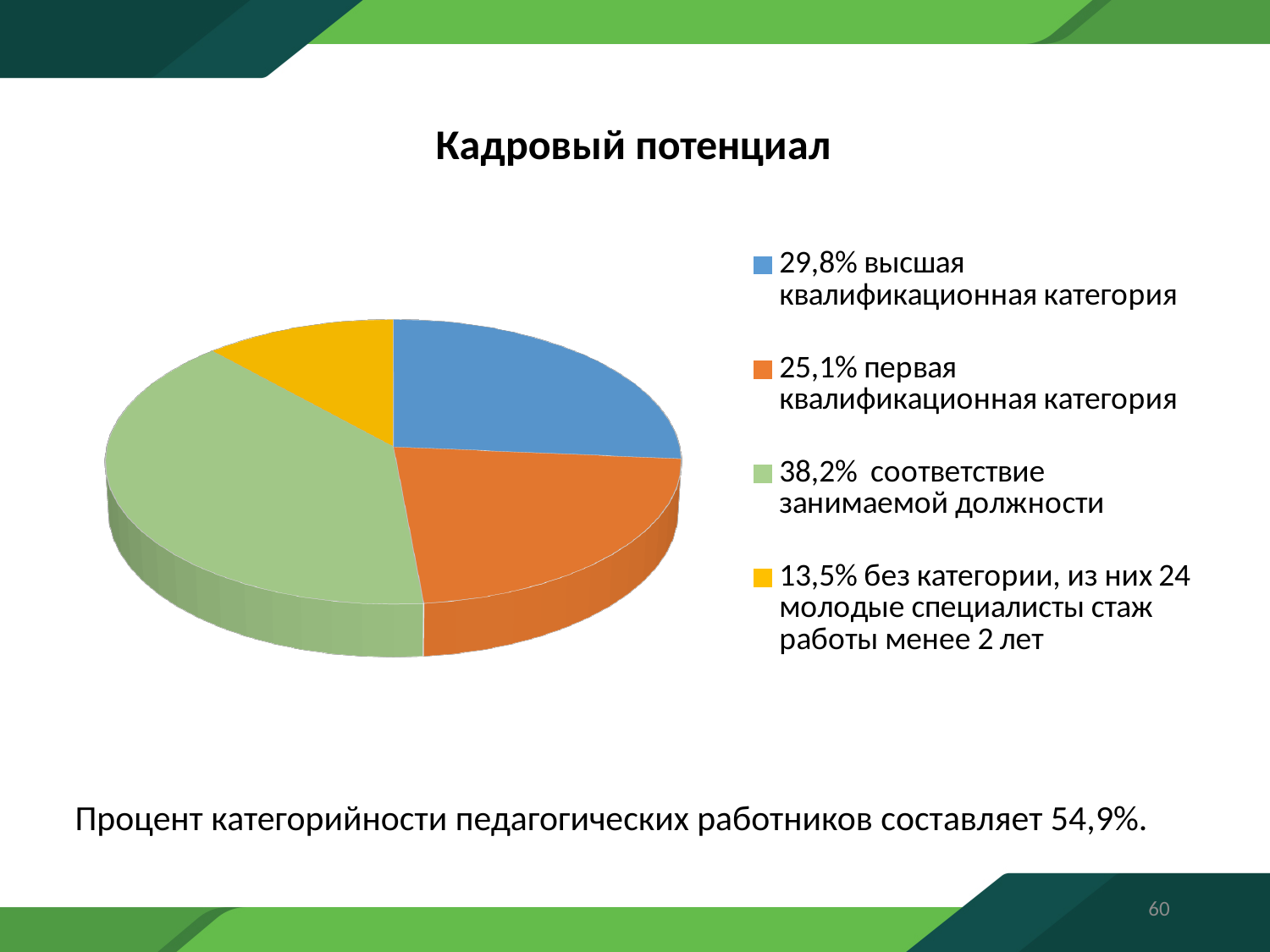
What share of the pie is 'первая квалификационная категория'? 25,1% What colour is the slice for 'без категории'? yellow Which category has the smallest share of the pie? без категории How many slices does the pie chart have? 4 What is the title of the chart? Кадровый потенциал What share of the pie is 'высшая квалификационная категория'? 29,8% Which is larger: the share for 'высшая квалификационная категория' or for 'первая квалификационная категория'? высшая квалификационная категория What is the difference between the share for 'соответствие занимаемой должности' and the share for 'без категории'? 24,7% What kind of chart is shown on the slide? pie chart Which category has the largest share of the pie? соответствие занимаемой должности What share of the pie is 'без категории'? 13,5%